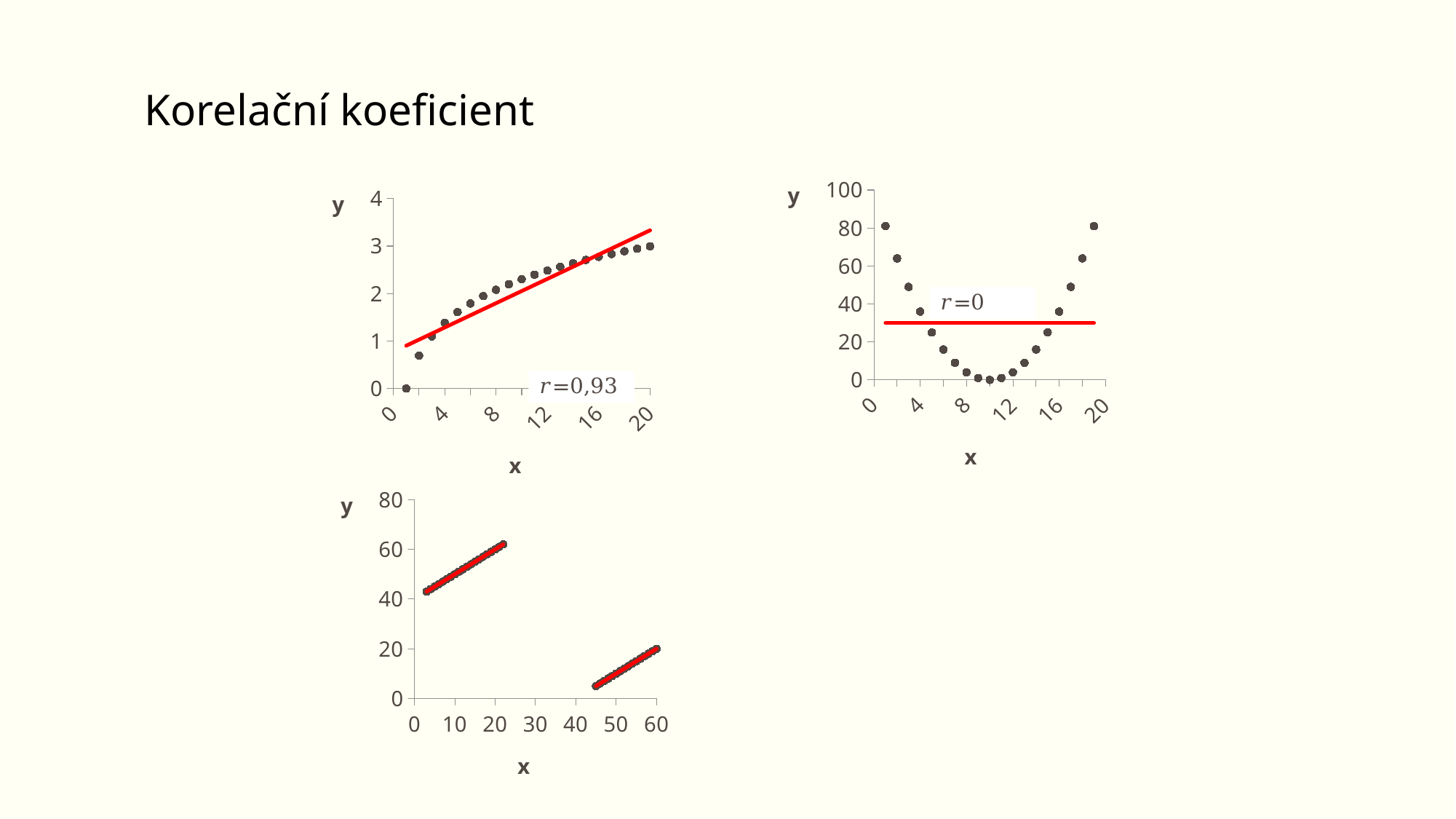
In the top-left chart, is the y value at x=20 greater or less than 2? greater In the top-left chart, do the y values rise or fall as x increases? rise What kind of chart is the top-right chart on the slide? scatter chart In the top-left chart, what correlation coefficient r is printed? r=0,93 How many charts are shown on the slide? 3 In the top-right chart, is the y value at x=1 greater or less than 60? greater In the bottom-left chart, is the y value at x=50 greater or less than 20? less In the top-right chart, do the y values rise or fall as x increases from 0 to 8? fall What kind of chart is the top-left chart on the slide? scatter chart In the top-right chart, what correlation coefficient r is printed? r=0